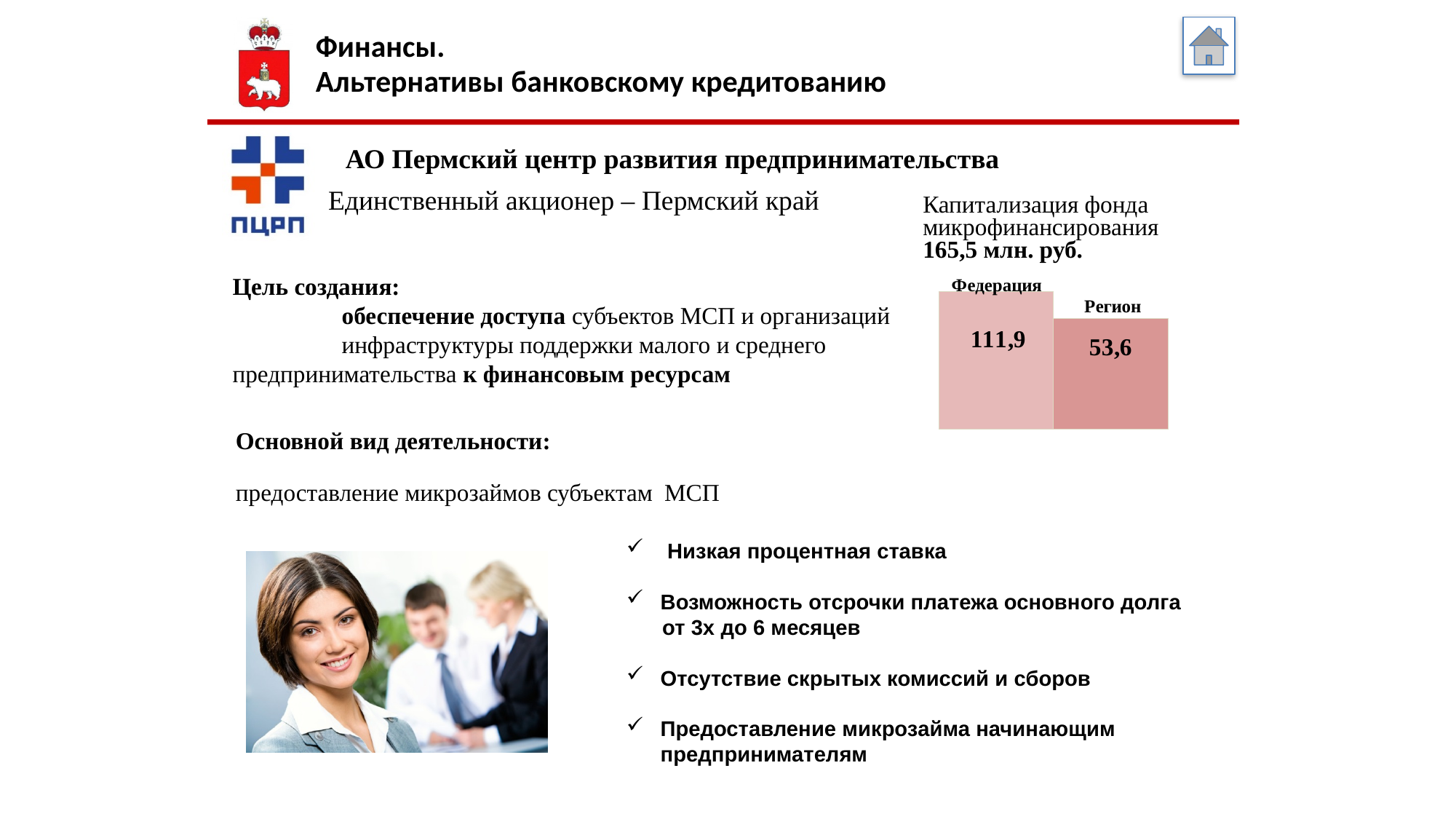
Which is larger in the bar chart, the value for Федерация or the value for Регион? Федерация How many bars are shown in the bar chart? 2 What kind of chart is shown on the slide? bar chart Which category has the highest value in the bar chart? Федерация What is the value shown for Регион in the bar chart? 53,6 What is the capitalization of the microfinance fund stated above the bar chart? 165,5 млн. руб. Which category has the lowest value in the bar chart? Регион Which bar in the chart is drawn in the darker shade of pink? Регион What is the difference between the values for Федерация and Регион in the bar chart? 58,3 What is the value shown for Федерация in the bar chart? 111,9 What is the total of the two values shown in the bar chart? 165,5